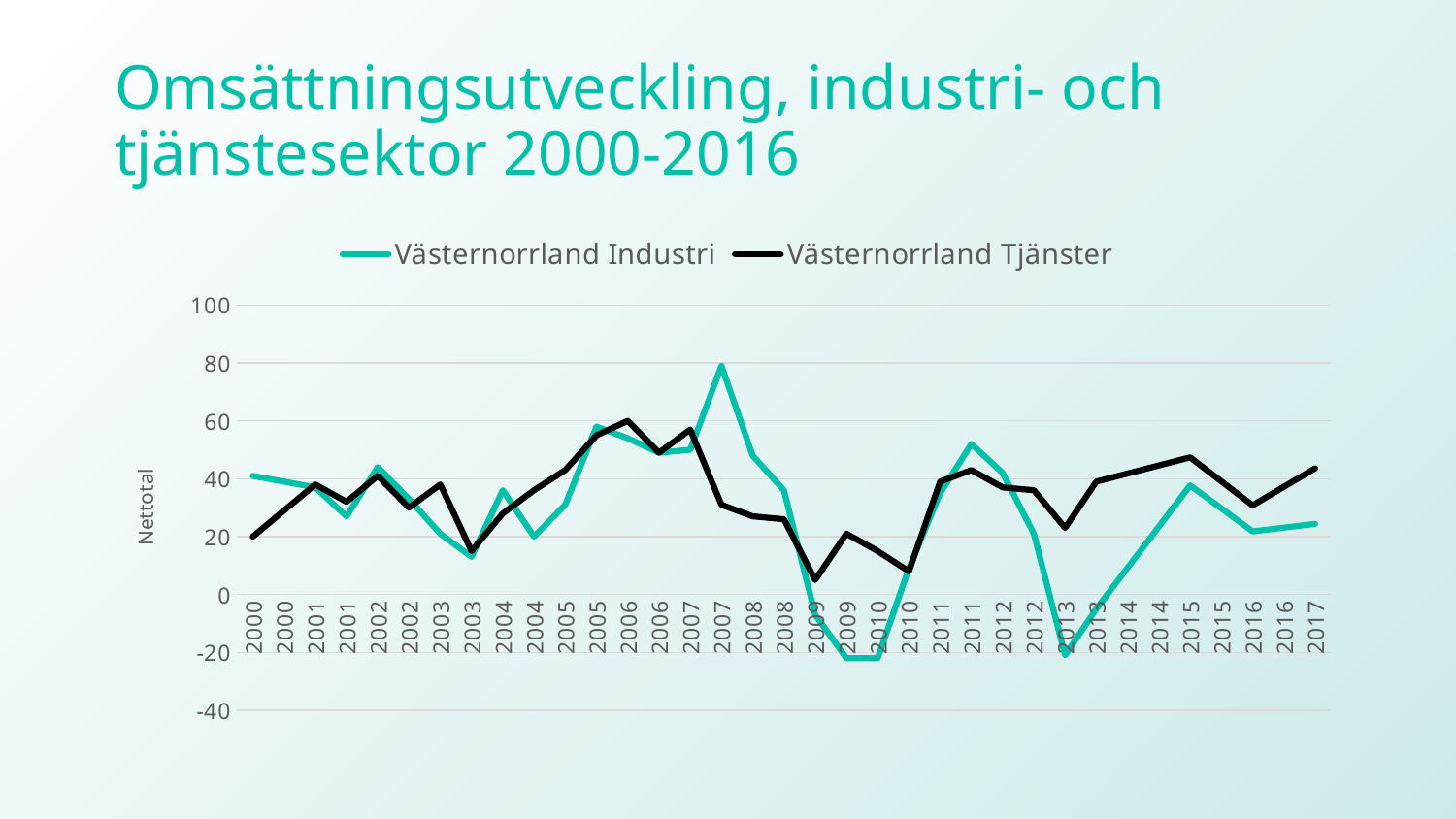
Does the Västernorrland Industri series rise or fall between its 2007 peak and 2009? fall Is the lowest value of Västernorrland Tjänster in 2009 greater or less than 20? less What are the two series named in the legend? Västernorrland Industri and Västernorrland Tjänster At the 2007 peak, which series has the higher value, Västernorrland Industri or Västernorrland Tjänster? Västernorrland Industri In which year does the Västernorrland Tjänster series reach its lowest value? 2009 At 2017, which series has the higher value, Västernorrland Industri or Västernorrland Tjänster? Västernorrland Tjänster What is the label on the vertical axis? Nettotal Is the value for Västernorrland Industri at the start of 2013 greater or less than 0? less What kind of chart is shown on the slide? line chart Is the peak value of Västernorrland Industri in 2007 greater or less than 60? greater In which year does the Västernorrland Industri series reach its highest value? 2007 How many series does the legend list? 2